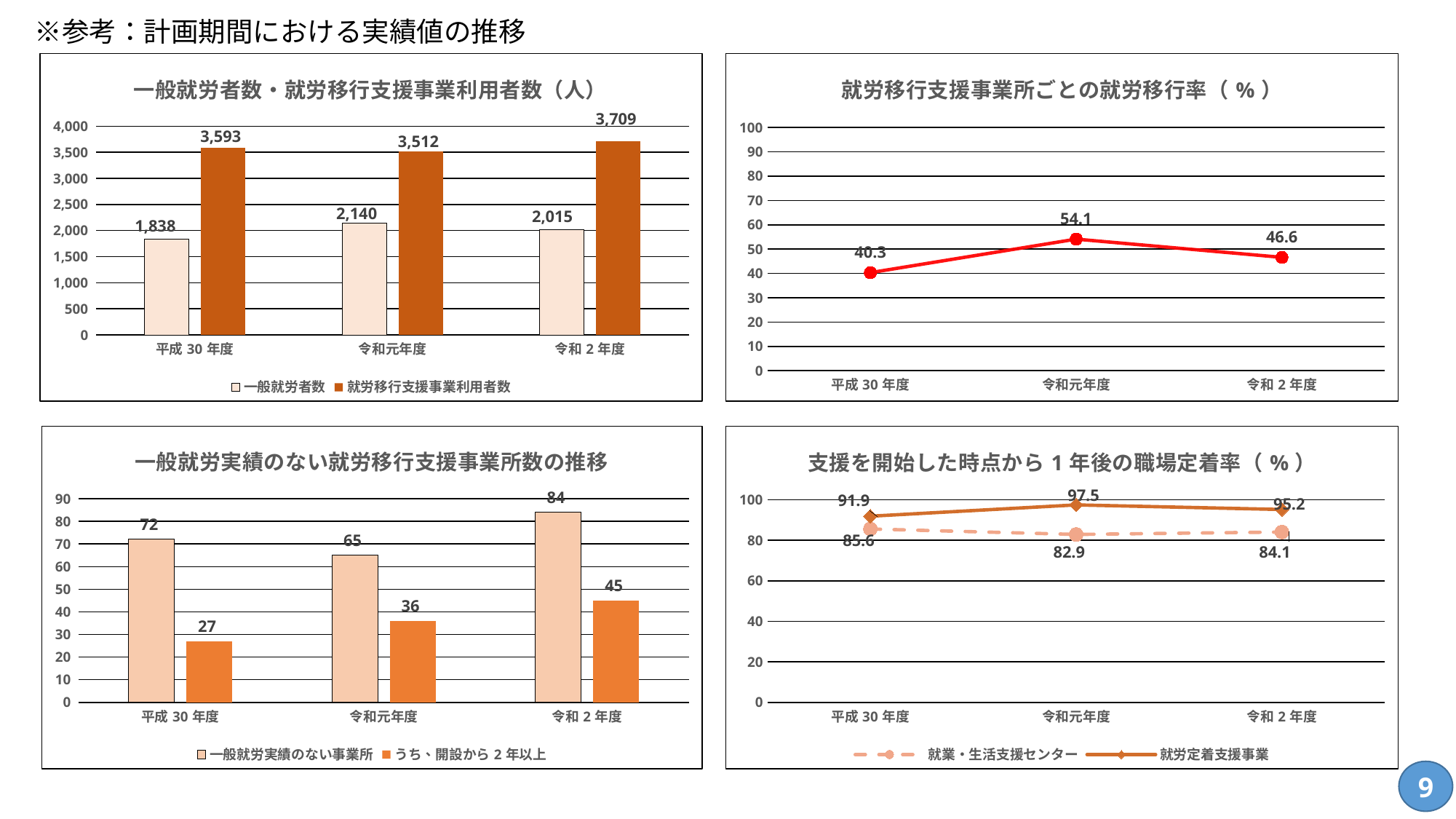
In the top-right chart (就労移行支援事業所ごとの就労移行率（％）), what is the value for 令和元年度? 54.1 In the bottom-left chart (一般就労実績のない就労移行支援事業所数の推移), what is the value of うち、開設から2年以上 for 令和元年度? 36 In the top-left chart (一般就労者数・就労移行支援事業利用者数（人）), what is the value of 就労移行支援事業利用者数 for 令和2年度? 3,709 In the top-left chart (一般就労者数・就労移行支援事業利用者数（人）), how many series does the legend list? 2 In the bottom-left chart (一般就労実績のない就労移行支援事業所数の推移), how many categories are shown on the x axis? 3 What kind of chart is the top-right chart (就労移行支援事業所ごとの就労移行率（％）)? Line chart In the bottom-right chart (支援を開始した時点から1年後の職場定着率（％）), what is the value of 就業・生活支援センター for 令和2年度? 84.1 In the top-left chart (一般就労者数・就労移行支援事業利用者数（人）), what is the difference between 就労移行支援事業利用者数 and 一般就労者数 in 平成30年度? 1,755 In the bottom-left chart (一般就労実績のない就労移行支援事業所数の推移), do the values for うち、開設から2年以上 rise or fall from 平成30年度 to 令和2年度? Rise In the bottom-right chart (支援を開始した時点から1年後の職場定着率（％）), which series has the larger value in 令和元年度, 就業・生活支援センター or 就労定着支援事業? 就労定着支援事業 In the top-left chart (一般就労者数・就労移行支援事業利用者数（人）), which year has the highest value for 一般就労者数? 令和元年度 In the top-right chart (就労移行支援事業所ごとの就労移行率（％）), which year has the lowest value? 平成30年度